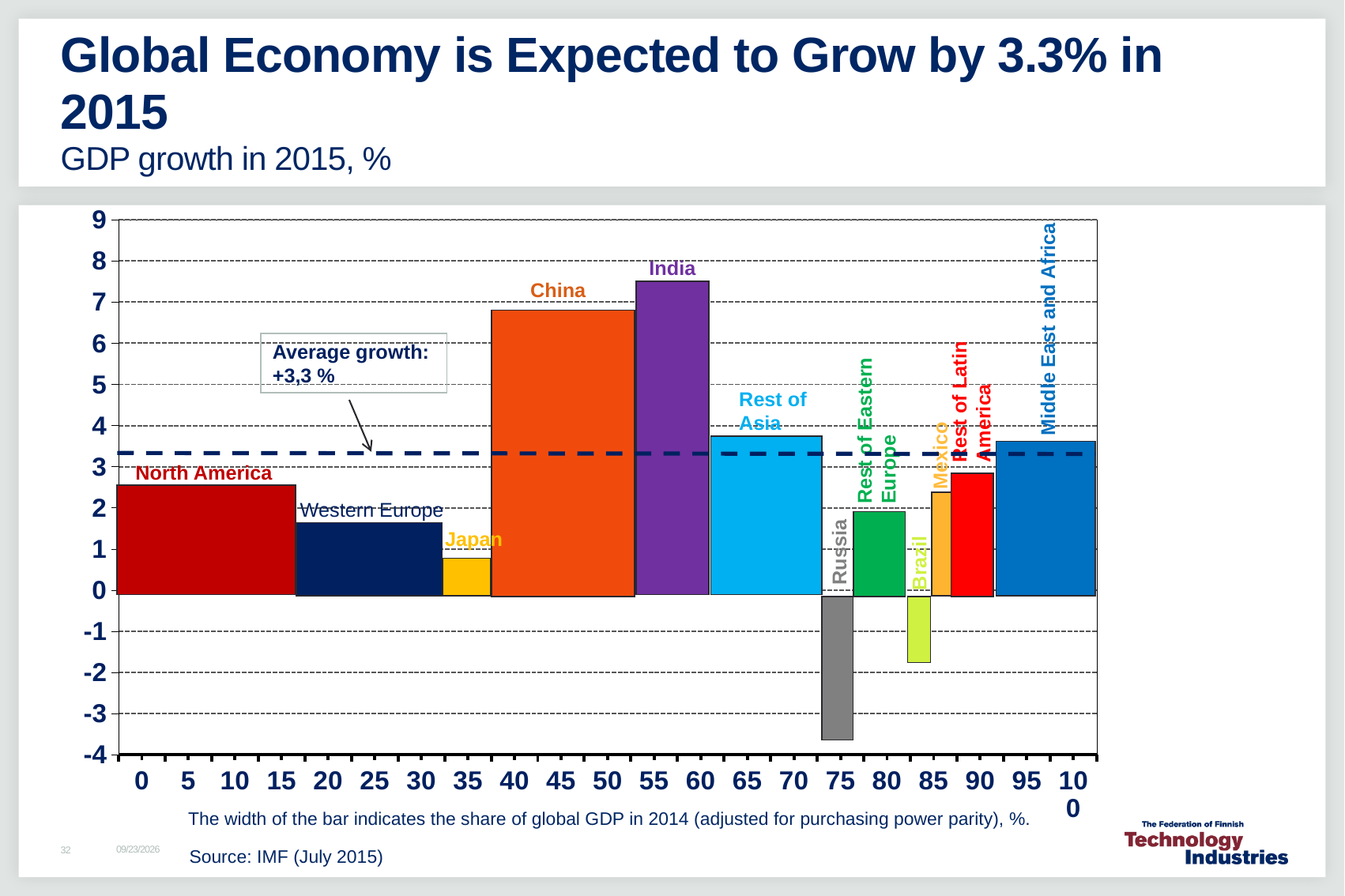
Which has the higher GDP growth in 2015, China or India? India Is the value for Russia greater or less than -3? less Is the value for China greater or less than 6? greater What kind of chart is shown on the slide? bar chart Is the value for Brazil greater or less than -1? less How many regions are plotted as bars on the chart? 12 Which region has the lowest GDP growth in 2015 on the chart? Russia What average growth rate is indicated by the dashed line on the chart? +3,3 % Which has the higher GDP growth in 2015, Japan or Western Europe? Western Europe Which region has the highest GDP growth in 2015 on the chart? India